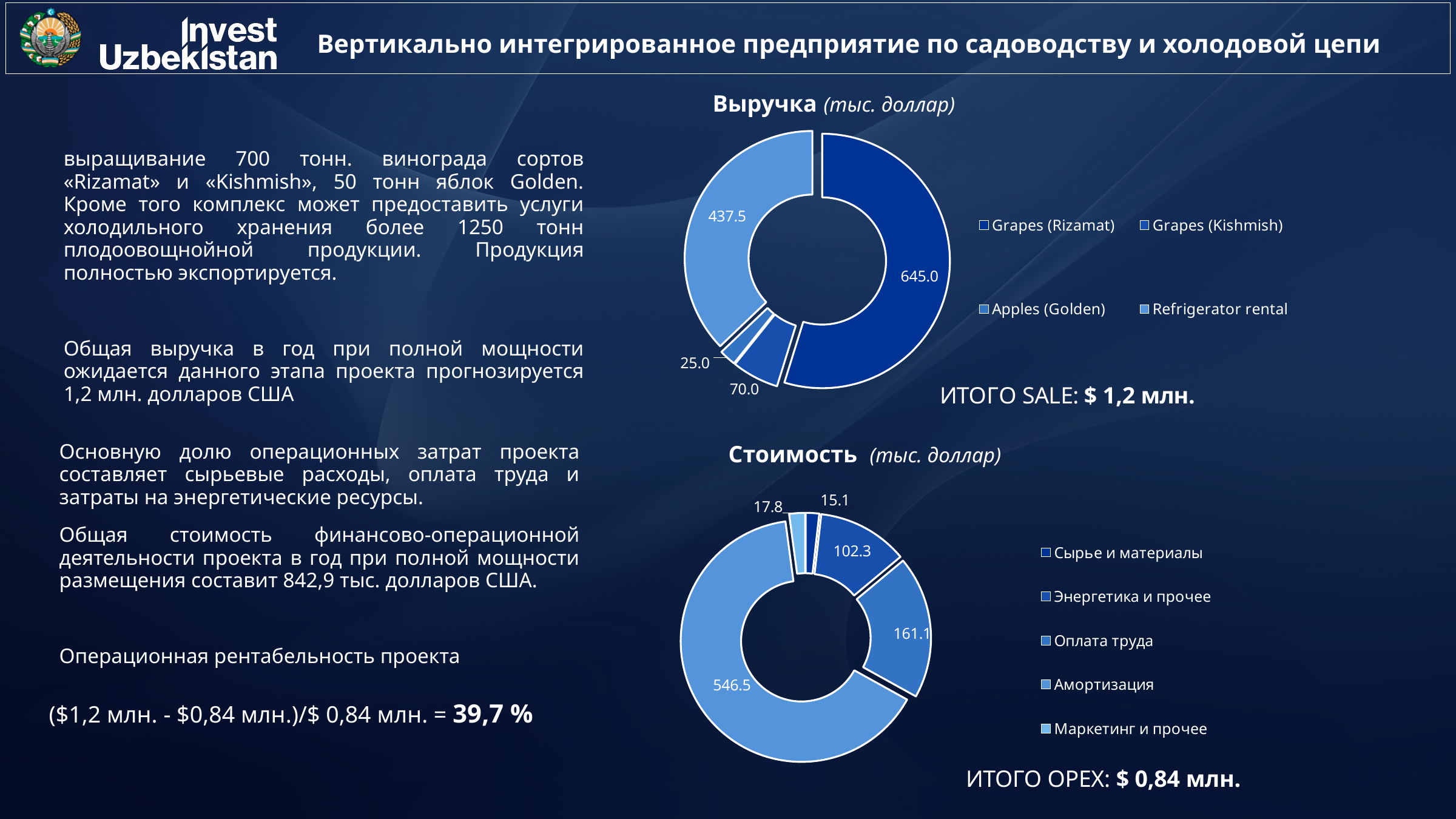
In the 'Выручка (тыс. доллар)' chart, what is the value for Refrigerator rental? 437.5 In the 'Стоимость (тыс. доллар)' chart, what is the smallest value shown? 15.1 In the 'Выручка (тыс. доллар)' chart, which is larger: Grapes (Kishmish) or Apples (Golden)? Grapes (Kishmish) In the 'Выручка (тыс. доллар)' chart, which category has the largest value? Grapes (Rizamat) In the 'Выручка (тыс. доллар)' chart, what is the value for Grapes (Rizamat)? 645.0 What kind of chart is the 'Выручка (тыс. доллар)' chart at the top right? Doughnut (pie) chart In the 'Выручка (тыс. доллар)' chart, which category has the smallest value? Apples (Golden) In the 'Стоимость (тыс. доллар)' chart, how many slices are there? 5 How many entries does the legend of the 'Стоимость (тыс. доллар)' chart list? 5 In the 'Выручка (тыс. доллар)' chart, how many slices are there? 4 In the 'Стоимость (тыс. доллар)' chart, what is the largest value shown? 546.5 In the 'Выручка (тыс. доллар)' chart, what is the difference between Grapes (Rizamat) and Refrigerator rental? 207.5